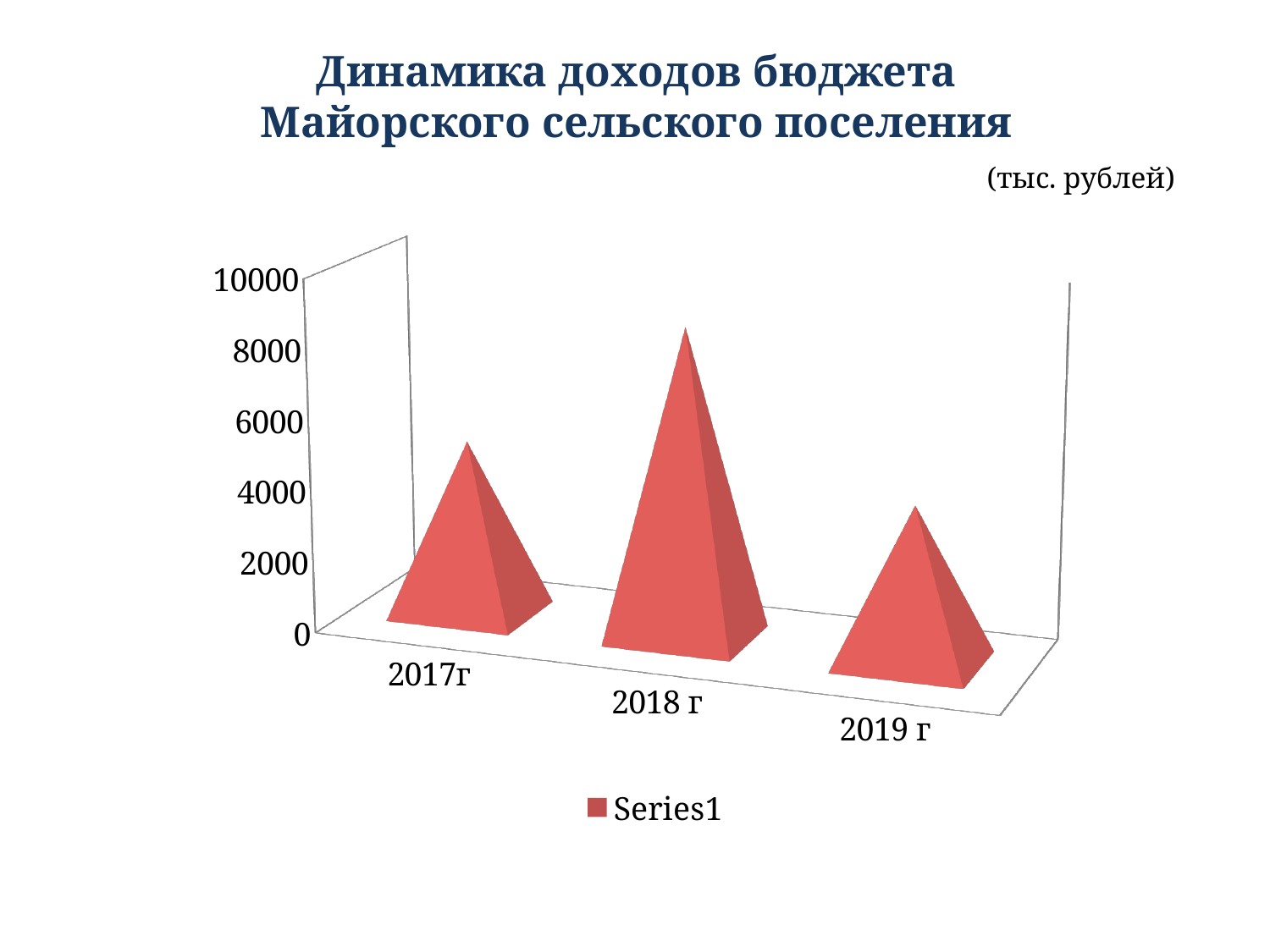
What is the title of the chart? Динамика доходов бюджета Майорского сельского поселения Is the value for 2018 г greater or less than 6000? greater Is the value for 2019 г greater or less than 6000? less Which year has the highest budget income in the chart? 2018 г Is the value for 2017г greater or less than 2000? greater Which is larger, the value for 2018 г or the value for 2019 г? 2018 г How many series does the legend list? 1 In what units are the values on the chart given, according to the slide? тыс. рублей Do the values rise or fall from 2018 г to 2019 г? fall What kind of chart is shown on the slide? bar chart How many categories (years) are shown on the x axis of the chart? 3